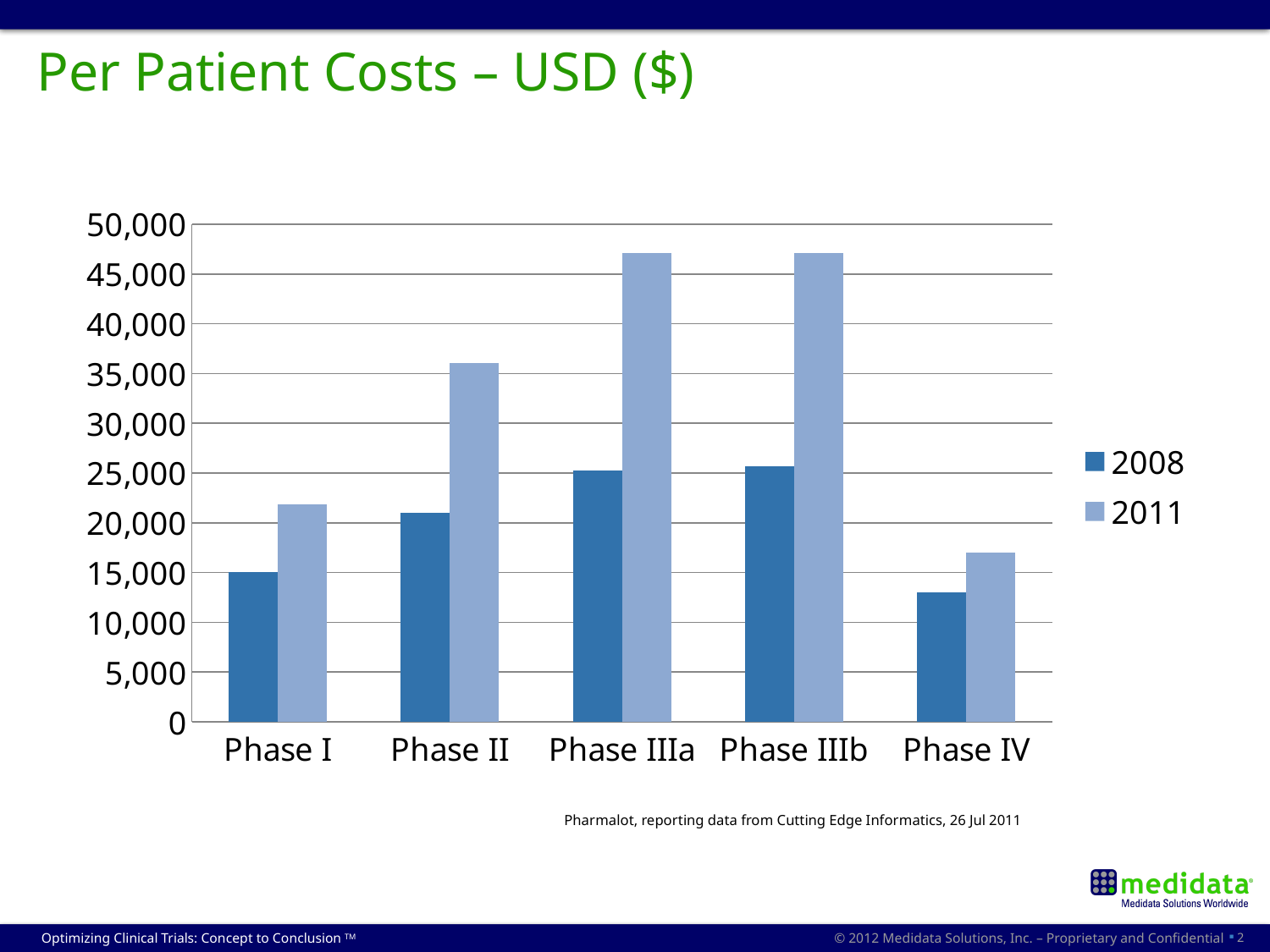
Which phase has the lowest per patient cost for 2011? Phase IV What kind of chart is shown on the slide? Bar chart How many series does the legend list? 2 How many phases are shown on the x axis? 5 Which phase has the lowest per patient cost for 2008? Phase IV What is the title of the slide? Per Patient Costs – USD ($) For Phase IIIa, which year has the higher per patient cost, 2008 or 2011? 2011 Is the 2011 value for Phase IIIa greater or less than 45,000? greater Which years are listed in the legend? 2008 and 2011 Is the 2011 value for Phase II greater or less than 30,000? greater Is the 2008 value for Phase IV greater or less than 15,000? less Which is larger, the 2011 value for Phase I or the 2011 value for Phase II? Phase II